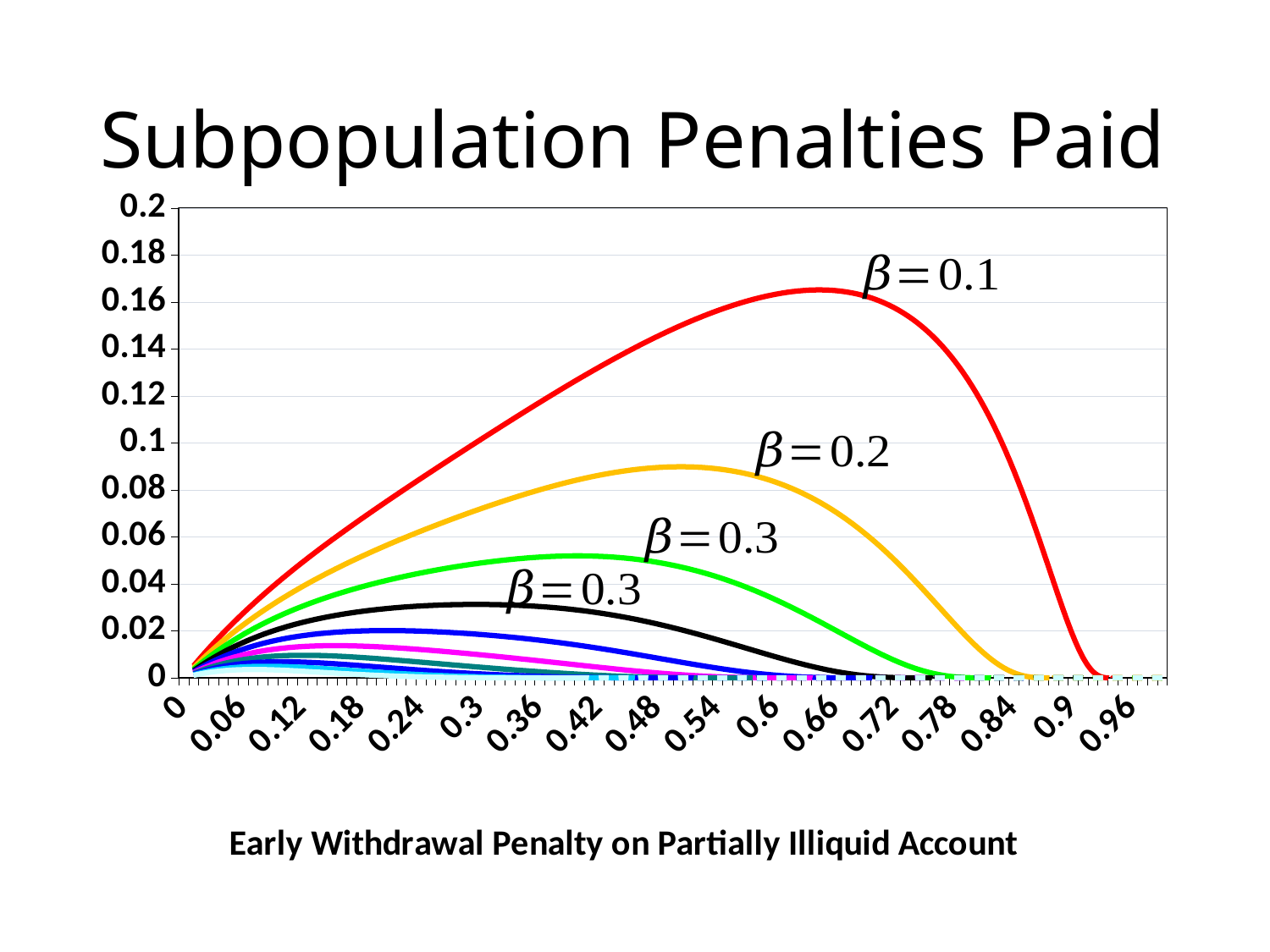
What is the title of the chart on the slide? Subpopulation Penalties Paid How does the β=0.1 curve behave as x increases from 0 to 0.96: does it rise throughout, fall throughout, or rise and then fall? rise and then fall Is the peak value of the green β=0.3 curve greater or less than 0.04? greater What is the label on the horizontal axis of the chart? Early Withdrawal Penalty on Partially Illiquid Account Which curve reaches a higher peak, β=0.1 or β=0.2? β=0.1 Is the value of the β=0.1 curve at x = 0.96 greater or less than 0.02? less Is the peak value of the β=0.1 curve greater or less than 0.14? greater Which curve reaches a higher peak, β=0.2 or β=0.3 (green)? β=0.2 Which labelled curve reaches the highest value on the chart? β=0.1 What kind of chart is shown on the slide? line chart